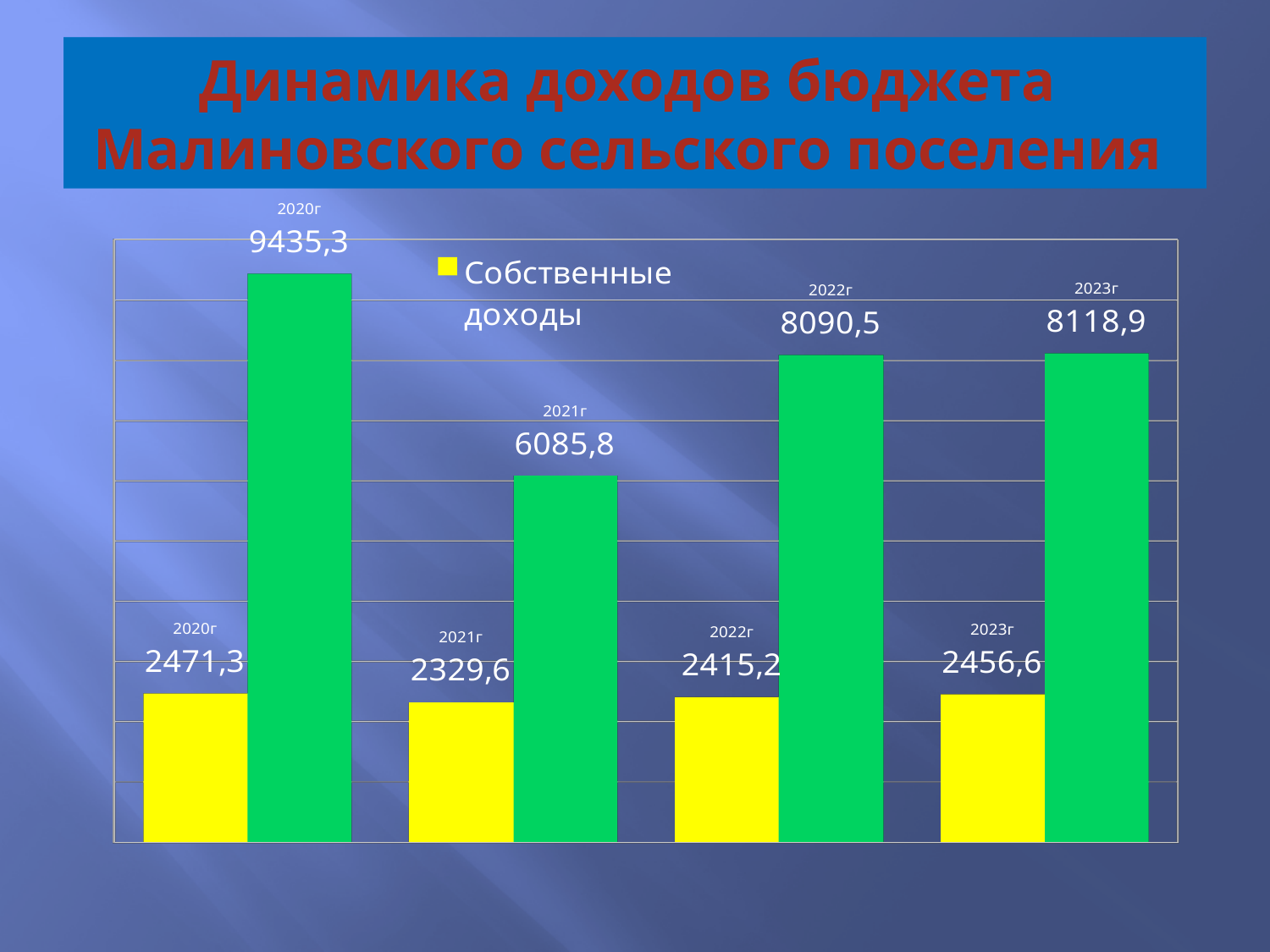
How many series does the legend list? 1 In which year is Собственные доходы lowest? 2021г What kind of chart is shown on the slide? bar chart How many years are shown on the x axis? 4 Which year has the larger green series value, 2022г or 2023г? 2023г Does the green series rise or fall from 2021г to 2023г? rise What is the value of Собственные доходы for 2023г? 2456,6 What is the value of the green series for 2021г? 6085,8 What is the difference between Собственные доходы for 2020г and 2021г? 141,7 What is the value of Собственные доходы for 2020г? 2471,3 What is the difference between the green series values for 2020г and 2021г? 3349,5 In which year is the green series highest? 2020г